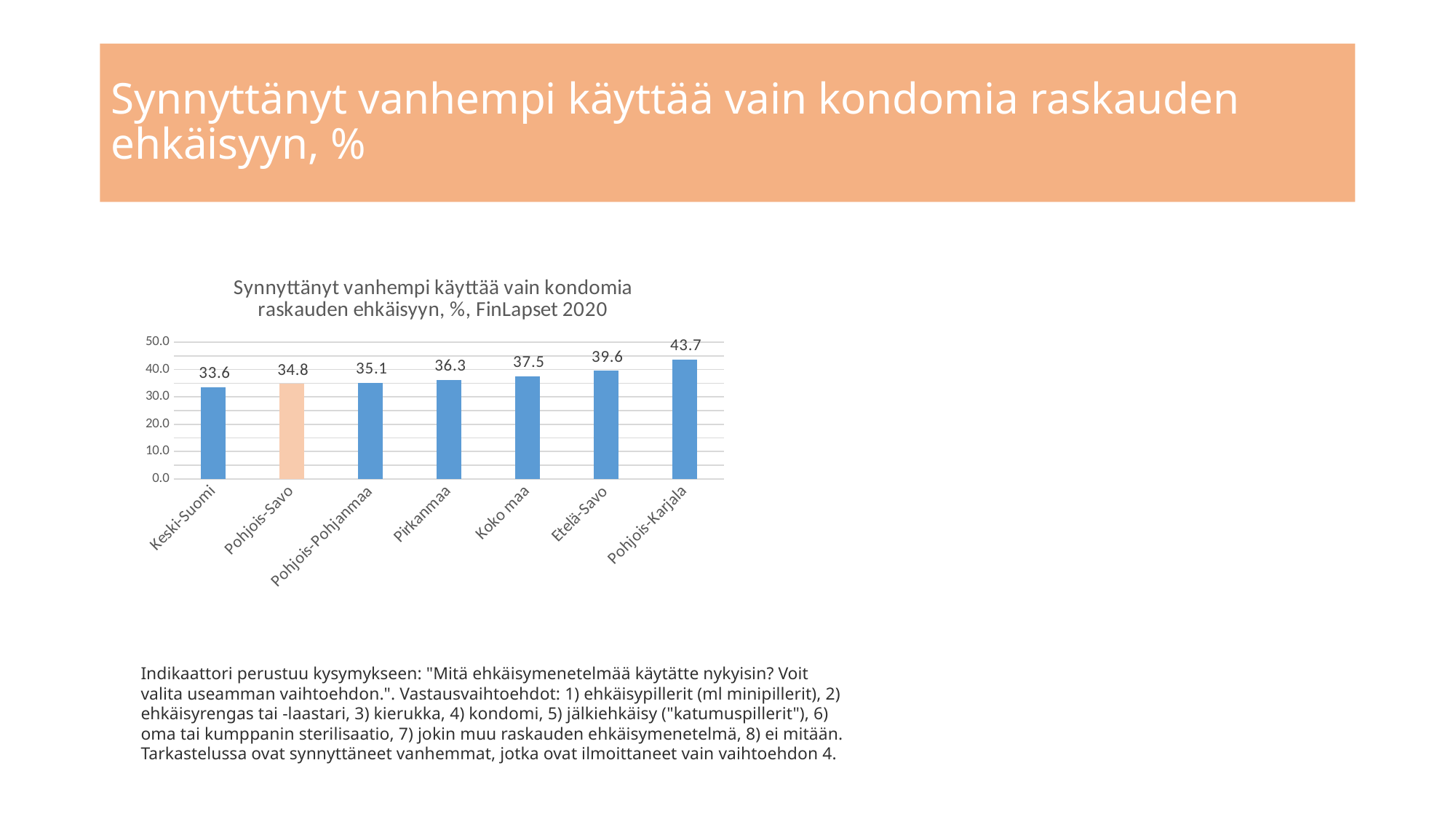
Is the value for Pohjois-Karjala greater or less than 40.0? greater Which is larger, the value for Pirkanmaa or the value for Pohjois-Pohjanmaa? Pirkanmaa What is the value for Pohjois-Savo? 34.8 What kind of chart is shown on the slide? bar chart What is the value for Koko maa? 37.5 What is the value for Etelä-Savo? 39.6 Which category has the lowest value? Keski-Suomi What is the difference between the values for Pohjois-Karjala and Keski-Suomi? 10.1 Which category has the highest value? Pohjois-Karjala Do the values rise or fall from left to right along the x axis? rise How many categories are shown on the x axis? 7 What is the value for Keski-Suomi? 33.6